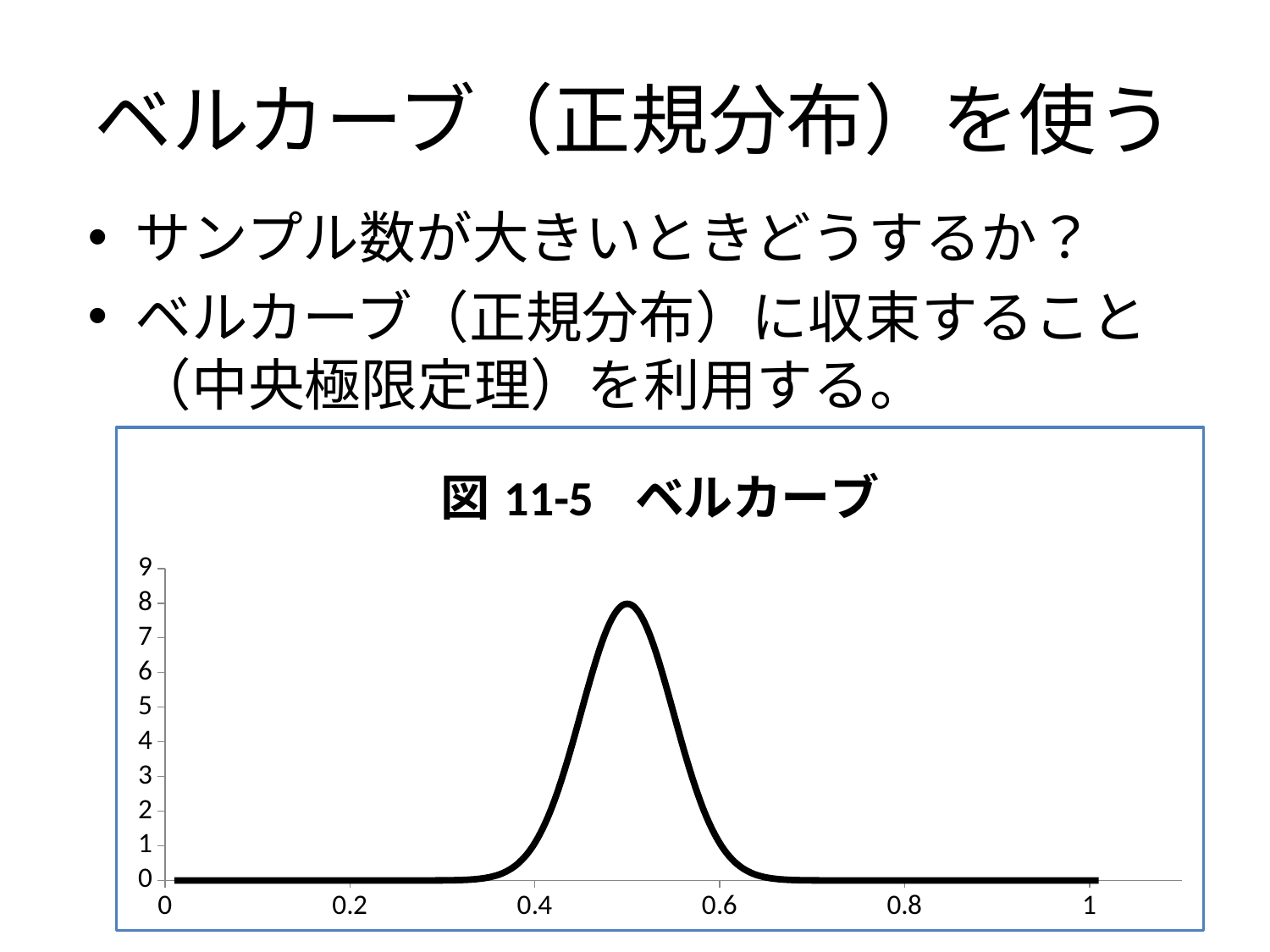
Is the value of the curve at x = 0.8 greater or less than 1? less Which is larger, the value of the curve at x = 0.5 or at x = 0.4? x = 0.5 Does the curve rise or fall as x goes from 0.5 to 0.6? fall Is the value of the curve at x = 0.2 greater or less than 1? less What is the title of the chart? 図 11-5 ベルカーブ Does the curve rise or fall as x goes from 0.4 to 0.5? rise How many labelled tick marks are on the x axis? 6 Is the value of the curve at x = 0.4 greater or less than 3? less What kind of chart is shown on the slide? line chart Between which two labelled x-axis ticks does the peak of the curve lie? 0.4 and 0.6